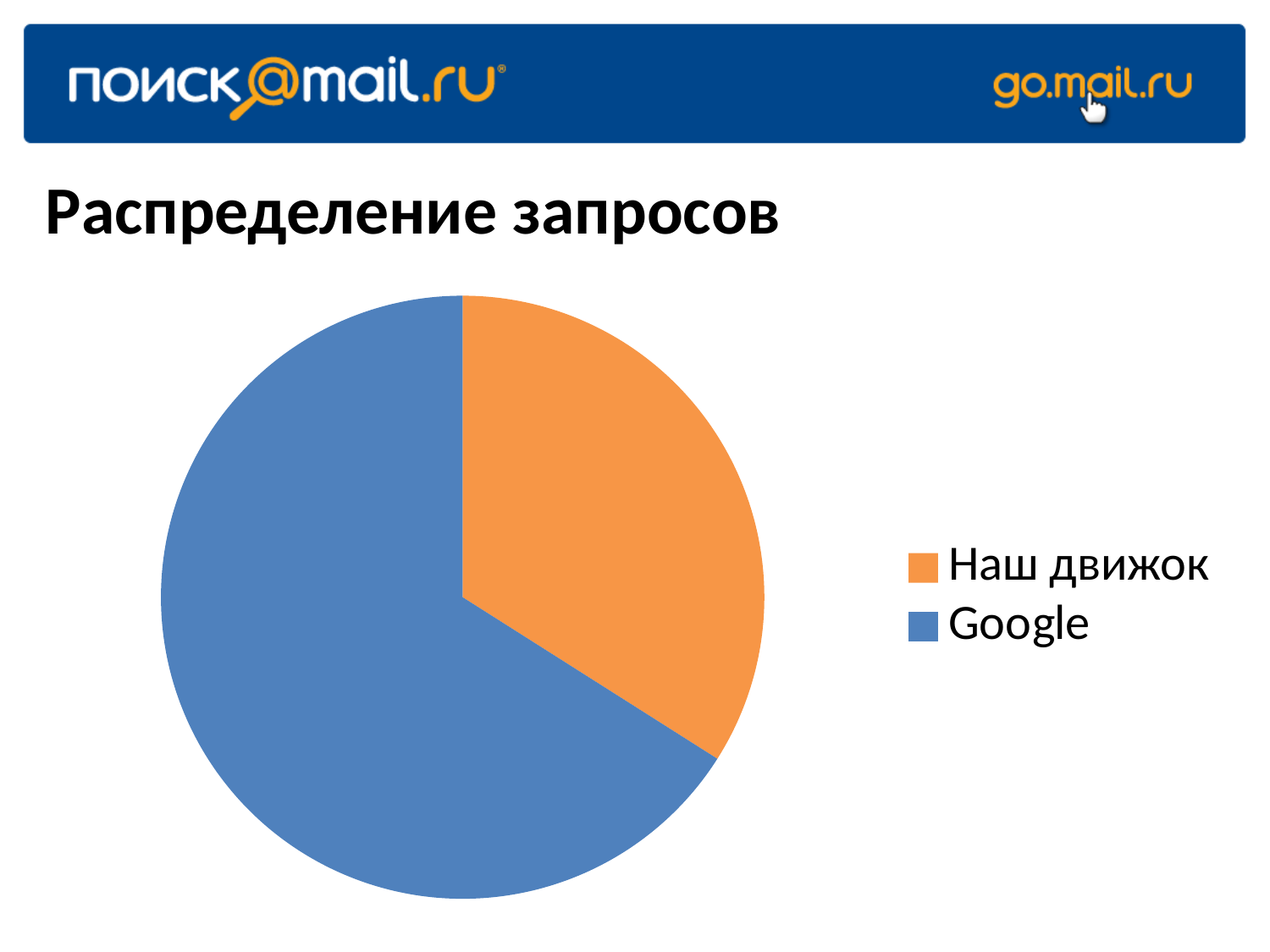
How many entries does the legend of the pie chart list? 2 Which category has the smallest slice in the pie chart? Наш движок What colour is the slice for Наш движок in the pie chart? orange What is the title of the chart on the slide? Распределение запросов Which slice is larger, Google or Наш движок? Google How many slices does the pie chart have? 2 What kind of chart is shown on the slide? pie chart Which category has the largest slice in the pie chart? Google